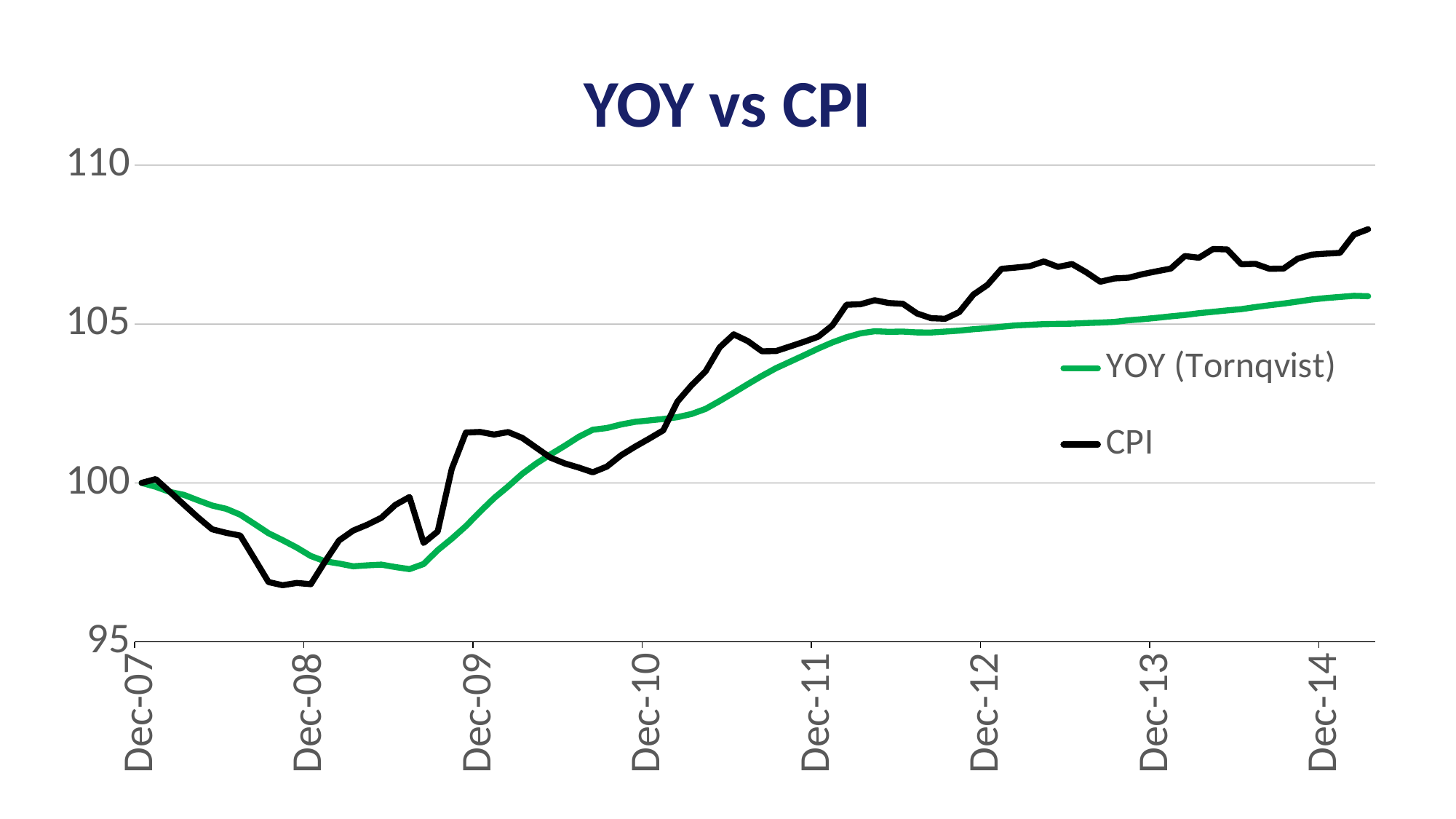
How many series does the legend list? 2 At Dec-14, which series has the higher value, YOY (Tornqvist) or CPI? CPI Is the value for CPI at Dec-14 greater or less than 105? greater Which colour is used for the CPI line? Black What is the title of the chart? YOY vs CPI What is the value of CPI at Dec-07? 100 How many labelled dates are shown on the x axis? 8 Overall, do the CPI values rise or fall from Dec-07 to Dec-14? Rise Is the value for YOY (Tornqvist) at Dec-10 greater or less than 100? greater Is the value for CPI at Dec-08 greater or less than 100? less What type of chart is shown on the slide? Line chart